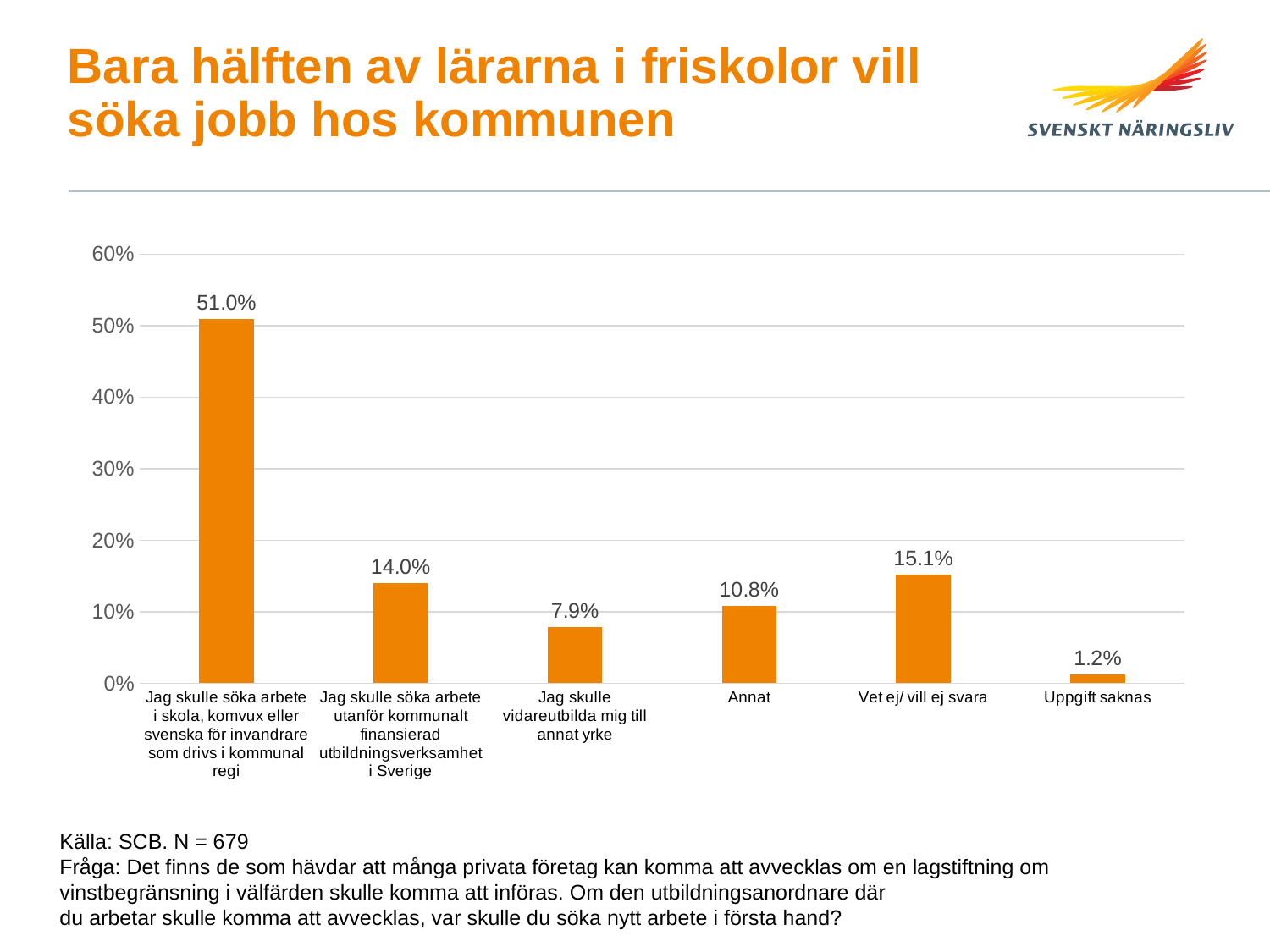
What is the difference between the value for "Vet ej/ vill ej svara" and the value for "Annat"? 4.3% What is the value for "Vet ej/ vill ej svara"? 15.1% What kind of chart is shown on the slide? bar chart Which category has the highest value? Jag skulle söka arbete i skola, komvux eller svenska för invandrare som drivs i kommunal regi How many categories are shown in the chart? 6 Which is larger: the value for "Jag skulle söka arbete utanför kommunalt finansierad utbildningsverksamhet i Sverige" or the value for "Vet ej/ vill ej svara"? Vet ej/ vill ej svara What is the value for "Annat"? 10.8% What is the sample size (N) given in the source note below the chart? 679 Is the value for "Annat" greater or less than 10%? greater What is the value for "Jag skulle vidareutbilda mig till annat yrke"? 7.9% What is the value for "Uppgift saknas"? 1.2% Which category has the lowest value? Uppgift saknas